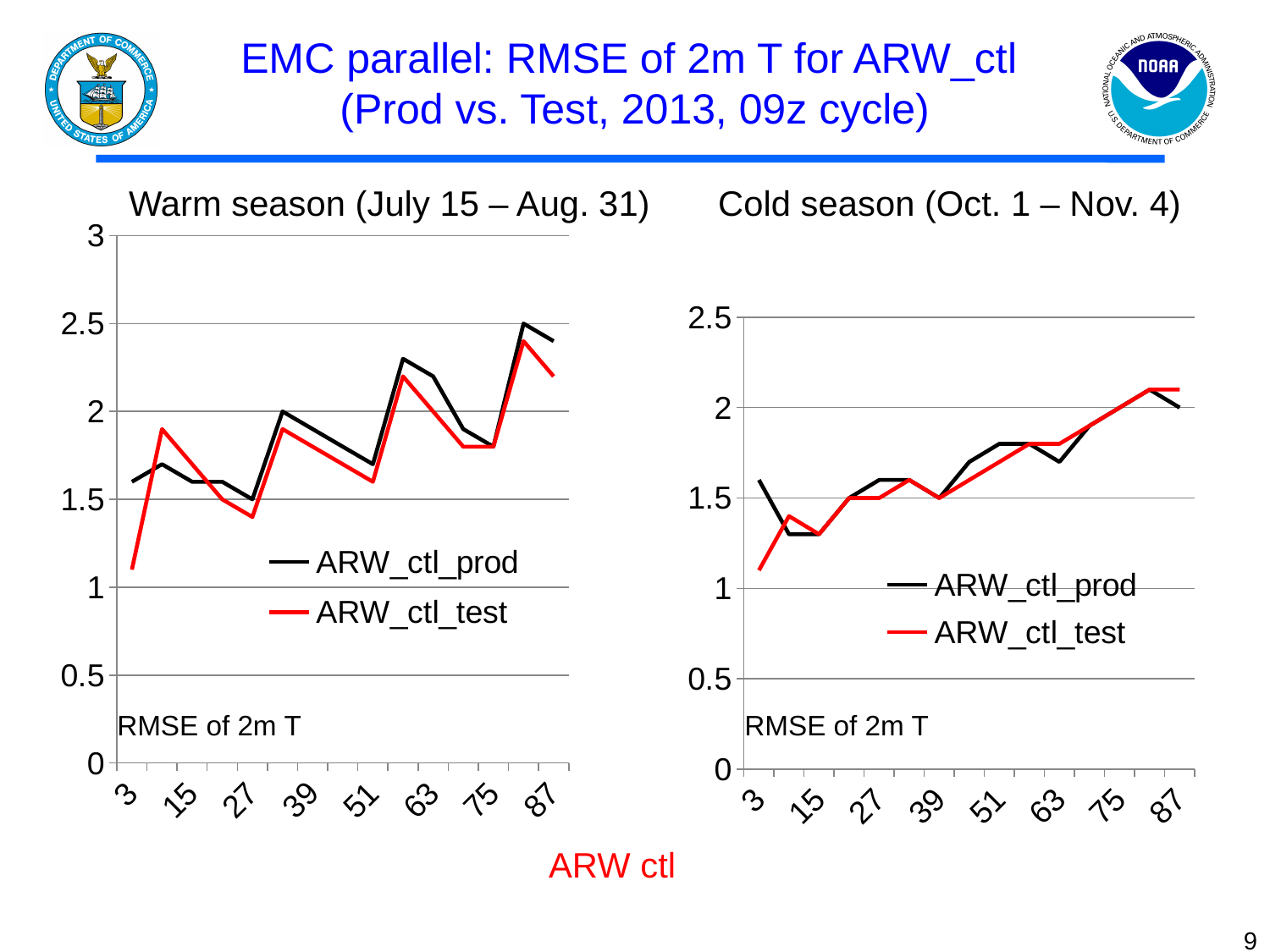
What kind of chart is used for the Warm season (July 15 – Aug. 31) panel? line chart In the Cold season chart, is the ARW_ctl_prod value at x = 75 greater or less than 1.5? greater In the Warm season chart, is the ARW_ctl_prod value at x = 63 greater or less than 2? greater In the Warm season chart, at x = 87, which series has the higher value, ARW_ctl_prod or ARW_ctl_test? ARW_ctl_prod In the Cold season chart, do the RMSE values generally rise or fall as the x axis increases from 3 to 87? rise In the Warm season chart, which two series are listed in the legend? ARW_ctl_prod and ARW_ctl_test In the Cold season chart, is the ARW_ctl_test value at x = 3 greater or less than 1.5? less How many labeled tick marks are shown on the x axis of the Cold season chart? 8 In the Warm season chart, at x = 3, which series has the higher value, ARW_ctl_prod or ARW_ctl_test? ARW_ctl_prod How many series does the legend list in the Cold season (Oct. 1 – Nov. 4) chart? 2 What is the highest value labeled on the y axis of the Warm season chart? 3